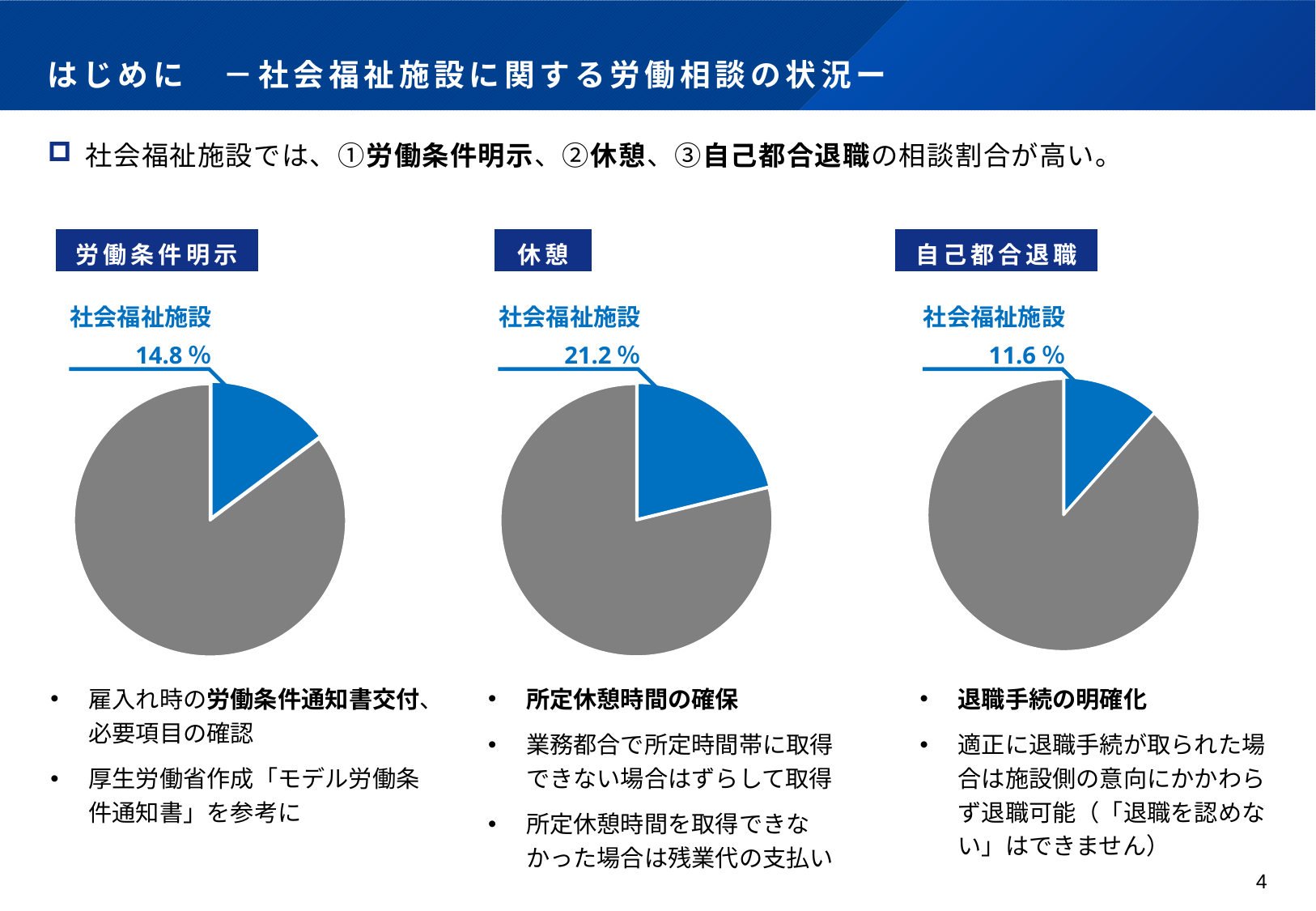
Which is larger: the 社会福祉施設 value in the 休憩 chart or in the 自己都合退職 chart? 休憩 Across the three pie charts, which chart shows the lowest 社会福祉施設 percentage? 自己都合退職 What is the difference between the 社会福祉施設 value in the 労働条件明示 chart and the 社会福祉施設 value in the 自己都合退職 chart? 3.2 % What type of chart is used for 労働条件明示, 休憩 and 自己都合退職 on this slide? Pie chart What is the difference between the 社会福祉施設 value in the 休憩 chart and the 社会福祉施設 value in the 労働条件明示 chart? 6.4 % How many pie charts are shown on the slide? 3 What share of the 休憩 pie chart does the 社会福祉施設 slice represent? 21.2 % In the 休憩 pie chart, what is the value shown for 社会福祉施設? 21.2 % Across the three pie charts, which chart shows the highest 社会福祉施設 percentage? 休憩 In the 労働条件明示 pie chart, what is the value shown for 社会福祉施設? 14.8 % In the 自己都合退職 pie chart, what is the value shown for 社会福祉施設? 11.6 % In the 自己都合退職 pie chart, what colour is the 社会福祉施設 slice? Blue